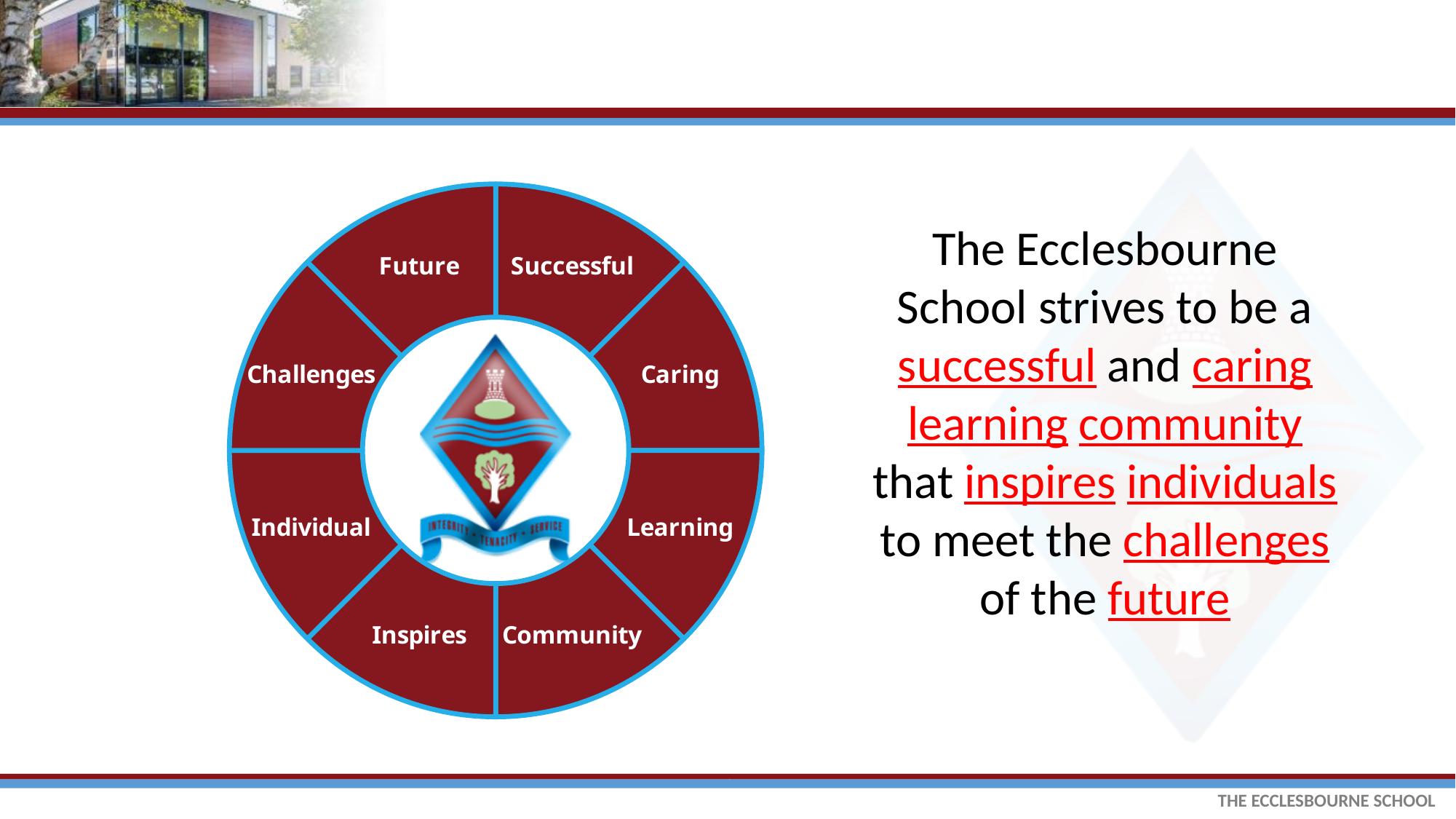
How many segments does the ring diagram on the left of the slide have? 8 What colour are the segments of the ring diagram? Dark red Which segment label appears at the far left of the ring, above 'Individual'? Challenges Which segment of the ring is labelled at the bottom right, next to 'Community'? Learning Which segment label sits directly to the right of the 'Future' segment at the top of the ring? Successful What kind of chart is the diagram on the left of the slide? Doughnut chart